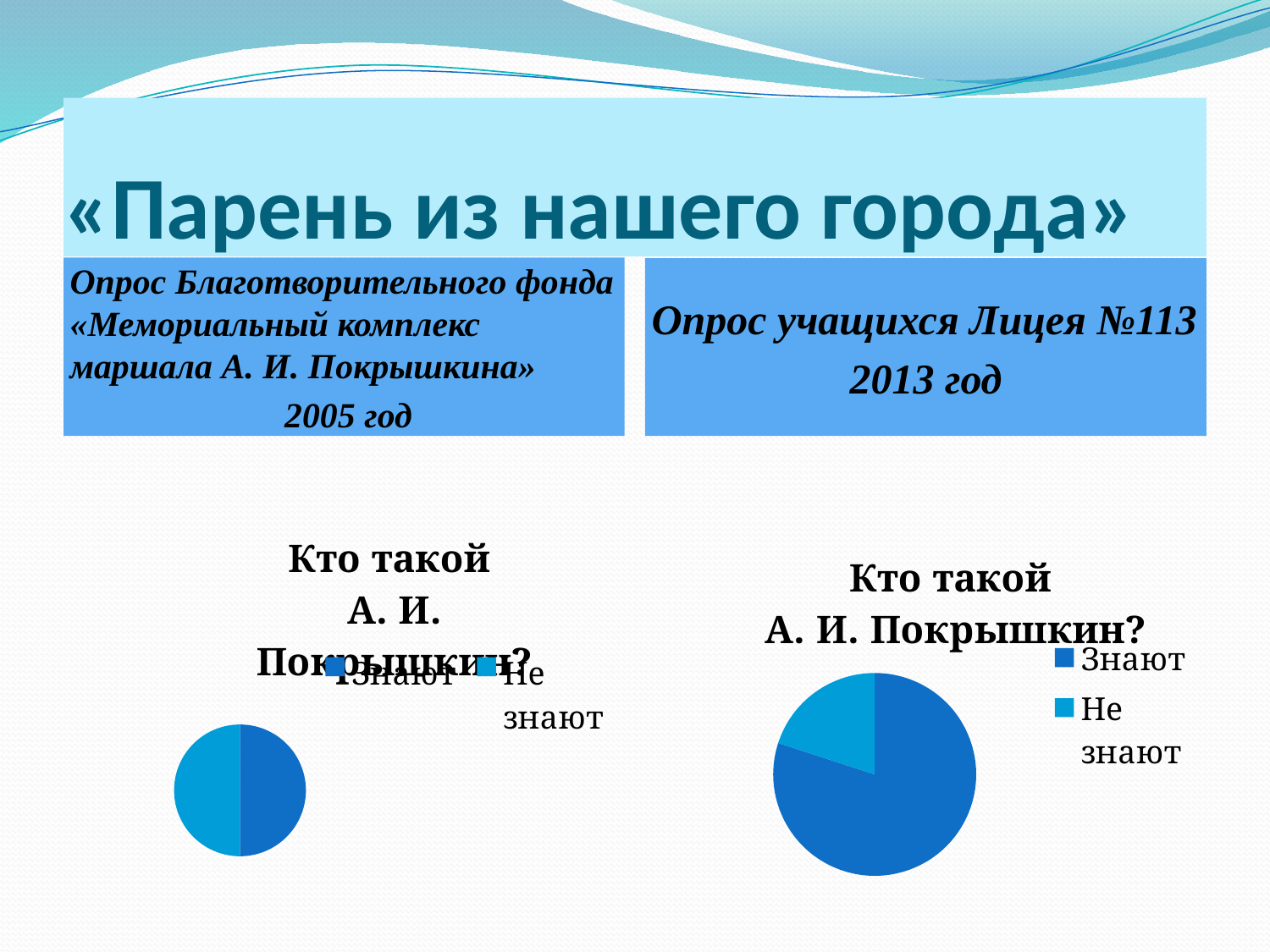
In the right pie chart, which category has the smallest share? Не знают In the right pie chart, which slice is larger: Знают or Не знают? Знают What kind of chart is the chart on the left of the slide? pie chart What is the title of the right pie chart? Кто такой А. И. Покрышкин? In the right pie chart, which category has the largest share? Знают How many entries does the legend of the right pie chart list? 2 How many slices does the left pie chart have? 2 What are the two legend entries of the left pie chart? Знают, Не знают What kind of chart is the chart on the right of the slide? pie chart